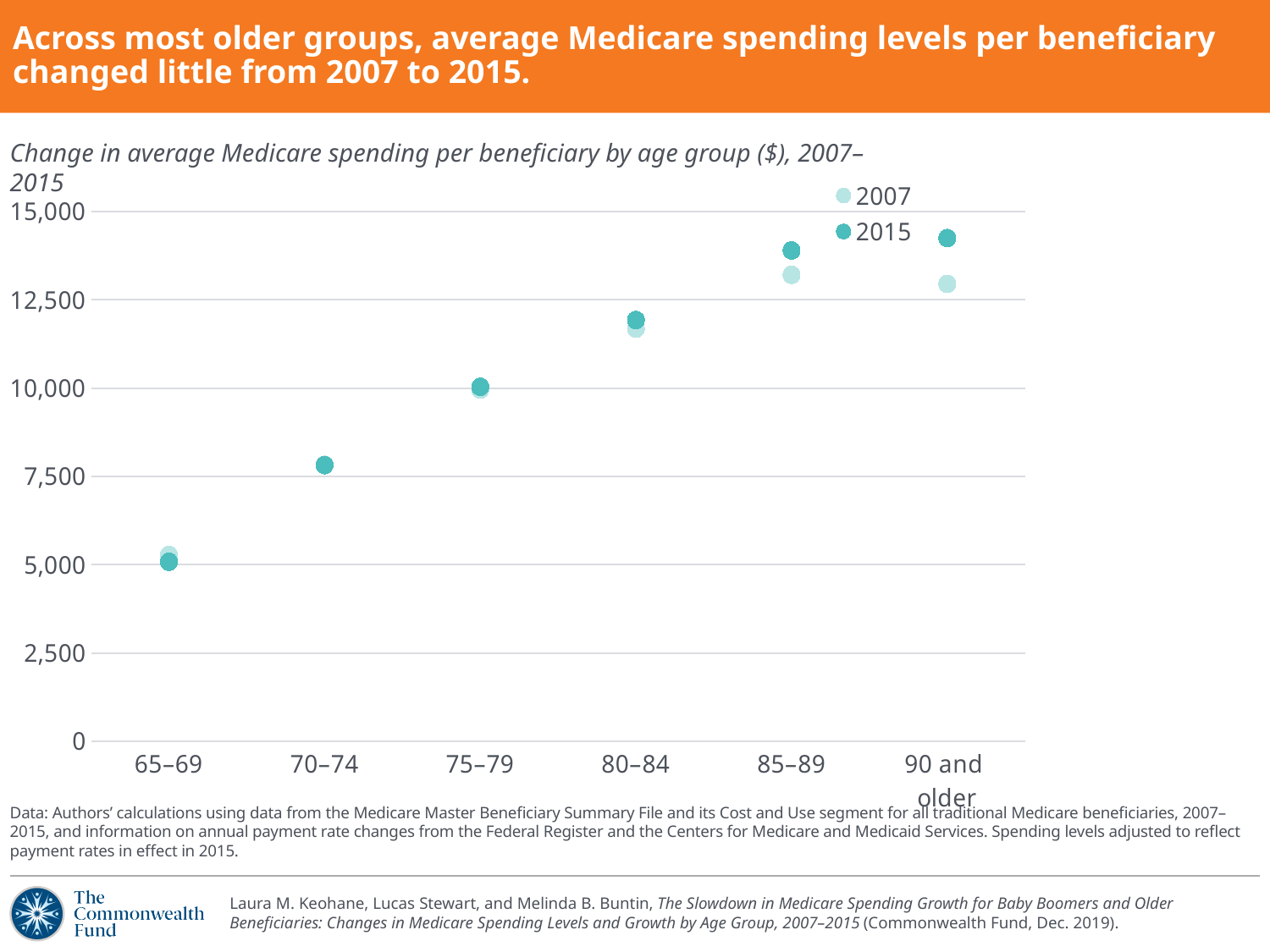
Which age group has the lowest average Medicare spending per beneficiary in 2015? 65–69 Is the 2007 value for the 70–74 age group greater or less than 10,000? less Is the 2007 value for the 90 and older age group greater or less than 12,500? greater For the 90 and older age group, which year has the larger value, 2007 or 2015? 2015 Is the 2015 value for the 65–69 age group greater or less than 7,500? less How many age groups are shown on the x axis? 6 How many series does the legend list? 2 Which series is shown in the darker teal colour in the legend? 2015 What kind of chart is shown on the slide? Scatter (dot) chart Which age group has the highest average Medicare spending per beneficiary in 2015? 90 and older Do the 2015 values rise or fall as age group increases from 65–69 to 90 and older? rise